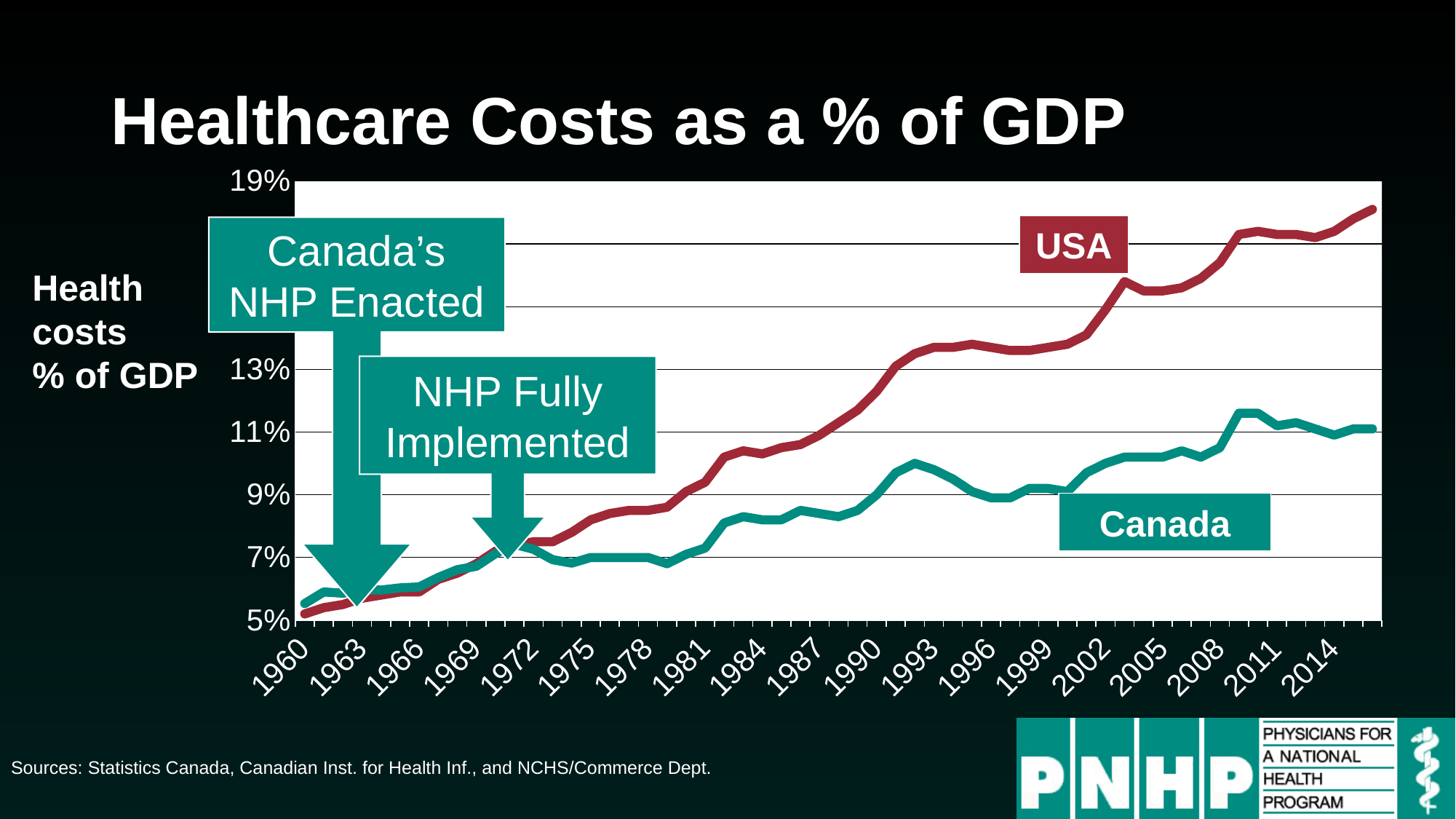
Is the USA value in 2014 greater or less than 13%? greater What kind of chart is shown on the slide? Line chart How many year labels are shown on the x axis? 19 Which country has the higher healthcare cost as a % of GDP in 1990? USA What is the title of the chart? Healthcare Costs as a % of GDP How many series does the chart plot? 2 Is the USA value in 1960 greater or less than 7%? less Does the USA line generally rise or fall from 1960 to 2014? Rise Is the Canada value in 1978 greater or less than 9%? less Which country has the higher healthcare cost as a % of GDP in 2014? USA Which two countries are plotted on the chart? USA and Canada